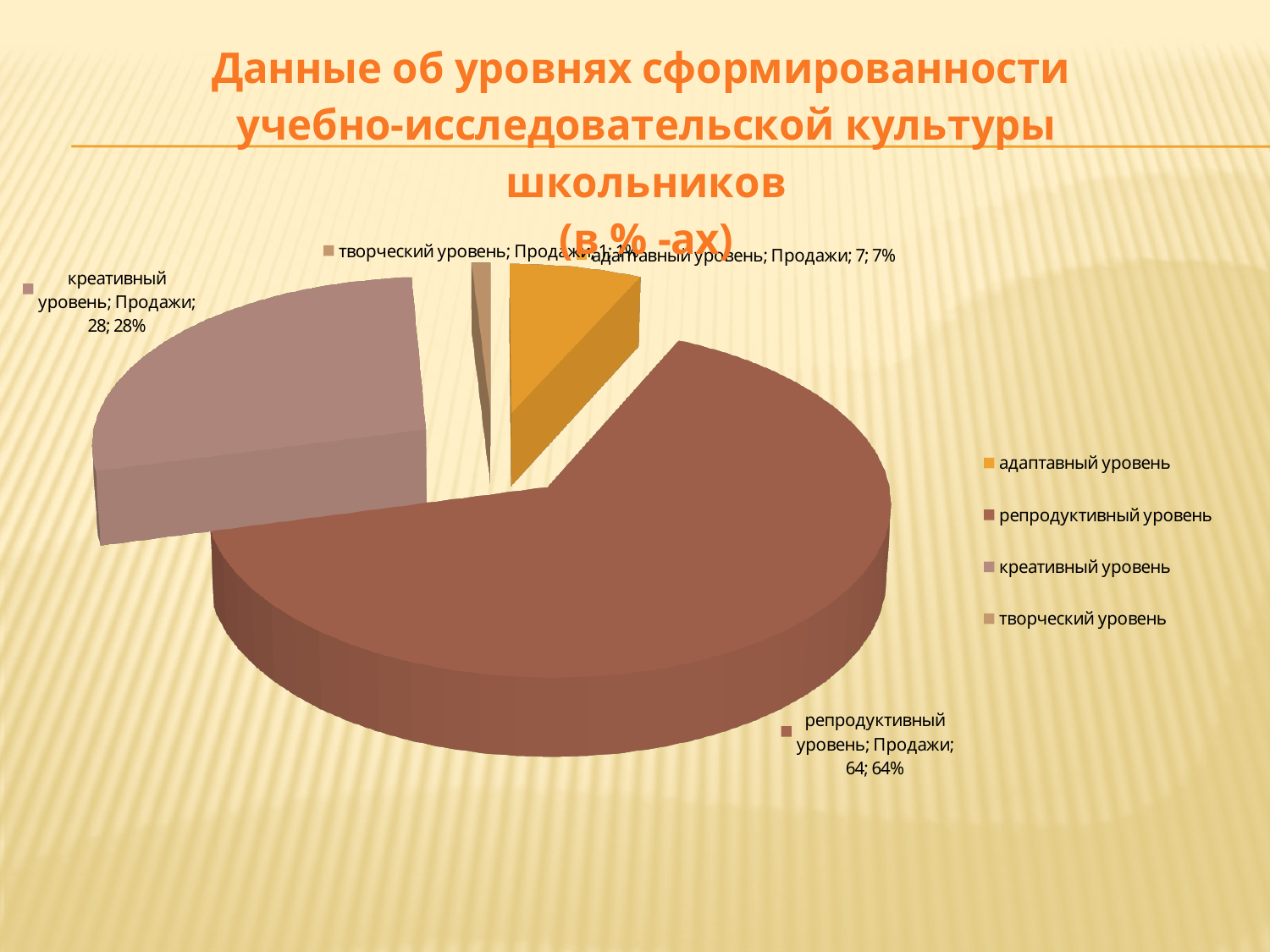
What percentage share does креативный уровень have? 28% What kind of chart is shown on the slide? pie chart What is the difference between the values for репродуктивный уровень and креативный уровень? 36 What is the value for адаптавный уровень? 7 What percentage share does репродуктивный уровень have? 64% Which is larger, the value for креативный уровень or the value for адаптавный уровень? креативный уровень How many entries does the legend list? 4 What is the value for репродуктивный уровень? 64 What colour is the slice for адаптавный уровень? orange Which level has the smallest slice of the pie? творческий уровень How many slices does the pie chart have? 4 Which level has the largest slice of the pie? репродуктивный уровень